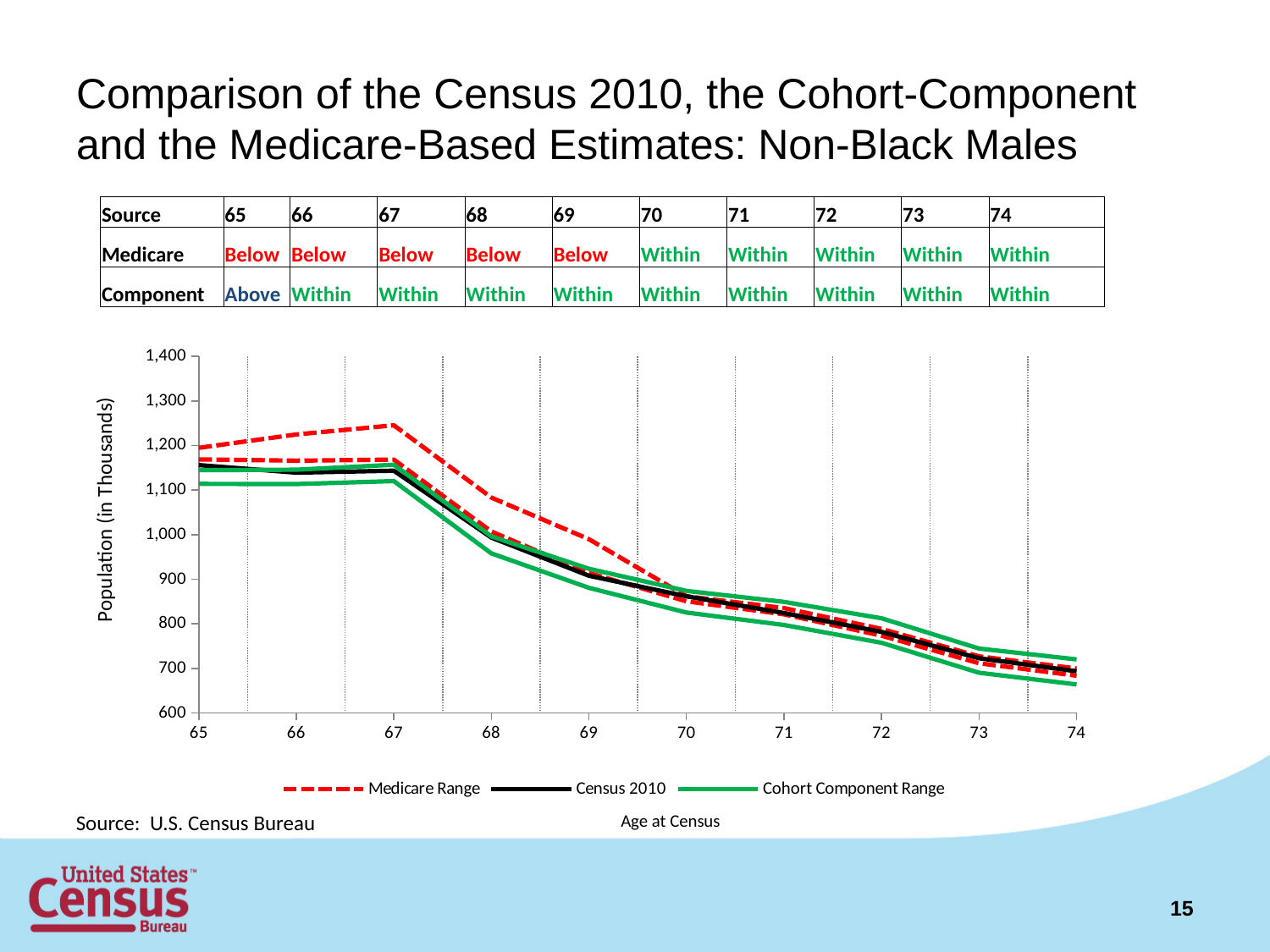
How many ages are plotted along the x axis of the chart? 10 How many series does the chart legend list? 3 Is the Census 2010 value at age 70 greater or less than 800? greater What kind of chart is shown on the slide? line chart What is the label of the y axis of the chart? Population (in Thousands) Which is larger, the Census 2010 value at age 67 or at age 69? age 67 At which age is the Census 2010 value lowest? 74 Is the Census 2010 value at age 67 greater or less than 1,000? greater Which legend entry is drawn as a red dashed line? Medicare Range Does the Census 2010 line rise or fall from age 67 to age 74? fall Is the Census 2010 value at age 72 greater or less than 900? less